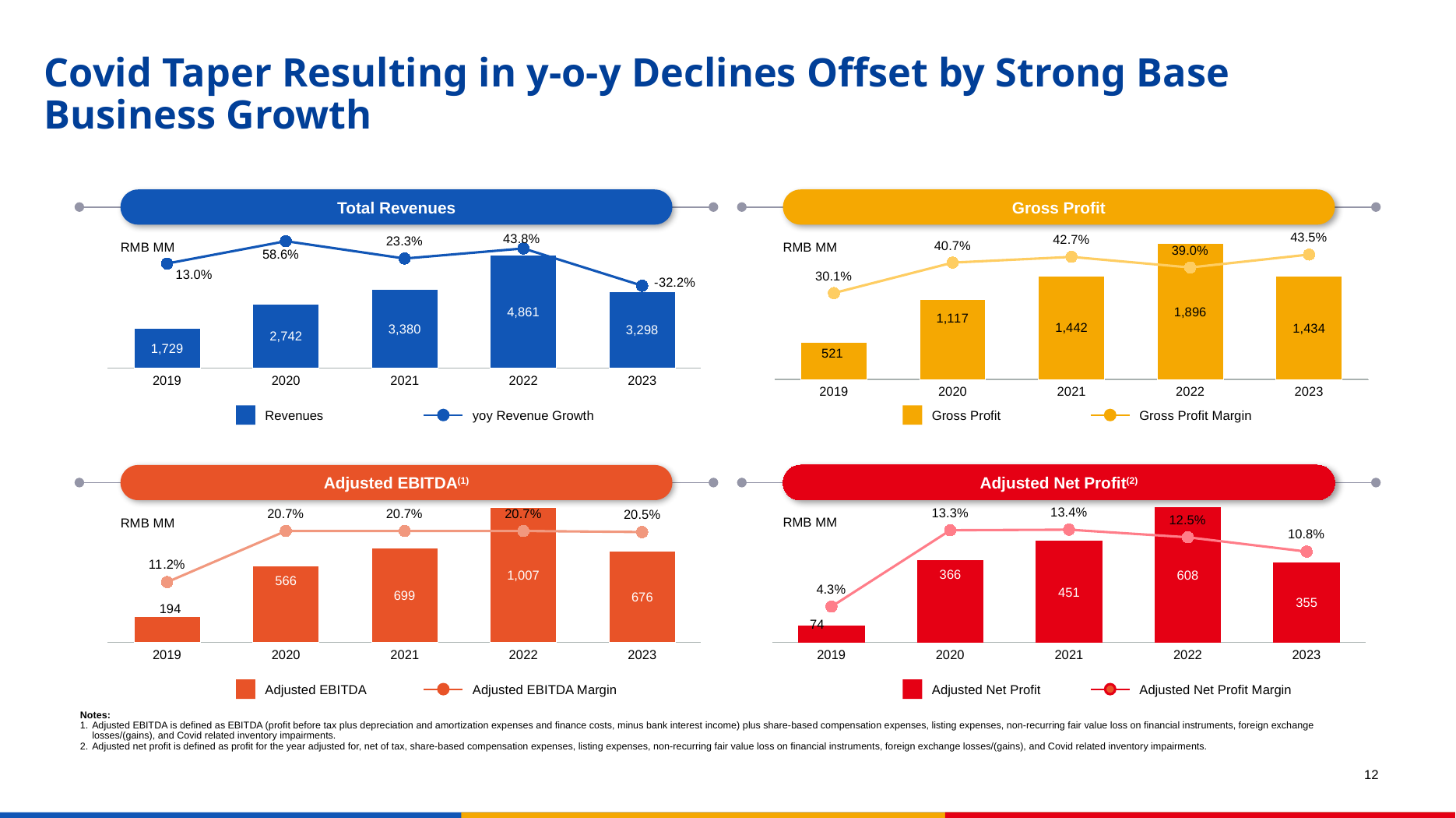
How many series does the legend of the Adjusted Net Profit chart list? 2 How many years are shown on the x axis of the Gross Profit chart? 5 In the Adjusted EBITDA chart, which year had the lowest adjusted EBITDA? 2019 In the Total Revenues chart, which is larger: revenue in 2021 or revenue in 2023? 2021 In the Gross Profit chart, what is the difference between gross profit in 2020 and 2019? 596 In the Total Revenues chart, what was the revenue in 2022? 4,861 In the Adjusted Net Profit chart, what was the adjusted net profit margin in 2023? 10.8% In the Total Revenues chart, what was the yoy revenue growth in 2023? -32.2% In the Adjusted Net Profit chart, what was the adjusted net profit in 2021? 451 In the Adjusted EBITDA chart, what is the difference between adjusted EBITDA in 2022 and 2023? 331 In the Gross Profit chart, what was the gross profit margin in 2019? 30.1% In the Gross Profit chart, which year had the highest gross profit? 2022